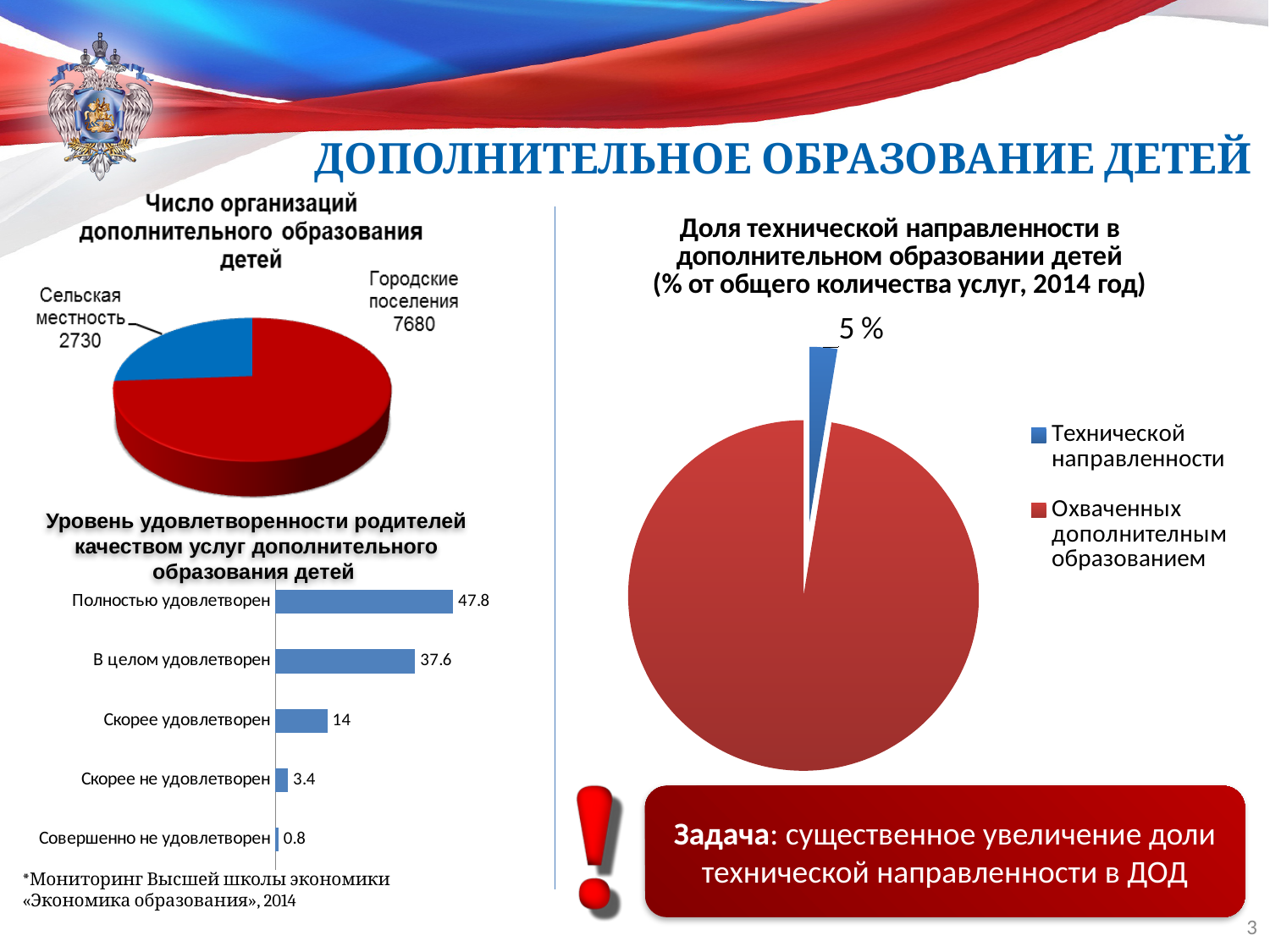
In the chart 'Число организаций дополнительного образования детей', how many organisations are in Сельская местность? 2730 In the chart 'Доля технической направленности в дополнительном образовании детей', what share does 'Технической направленности' have? 5 % How many entries does the legend of the chart 'Доля технической направленности в дополнительном образовании детей' list? 2 What kind of chart is 'Число организаций дополнительного образования детей'? Pie chart In the chart 'Уровень удовлетворенности родителей качеством услуг дополнительного образования детей', which category has the lowest value? Совершенно не удовлетворен How many categories are shown in the chart 'Уровень удовлетворенности родителей качеством услуг дополнительного образования детей'? 5 In the chart 'Число организаций дополнительного образования детей', what is the difference between Городские поселения and Сельская местность? 4950 In the chart 'Уровень удовлетворенности родителей качеством услуг дополнительного образования детей', what is the value for 'Полностью удовлетворен'? 47.8 In the chart 'Уровень удовлетворенности родителей качеством услуг дополнительного образования детей', what is the difference between 'Полностью удовлетворен' and 'В целом удовлетворен'? 10.2 In the chart 'Уровень удовлетворенности родителей качеством услуг дополнительного образования детей', which category has the highest value? Полностью удовлетворен In the chart 'Число организаций дополнительного образования детей', how many organisations are in Городские поселения? 7680 In the chart 'Уровень удовлетворенности родителей качеством услуг дополнительного образования детей', what is the value for 'Скорее не удовлетворен'? 3.4